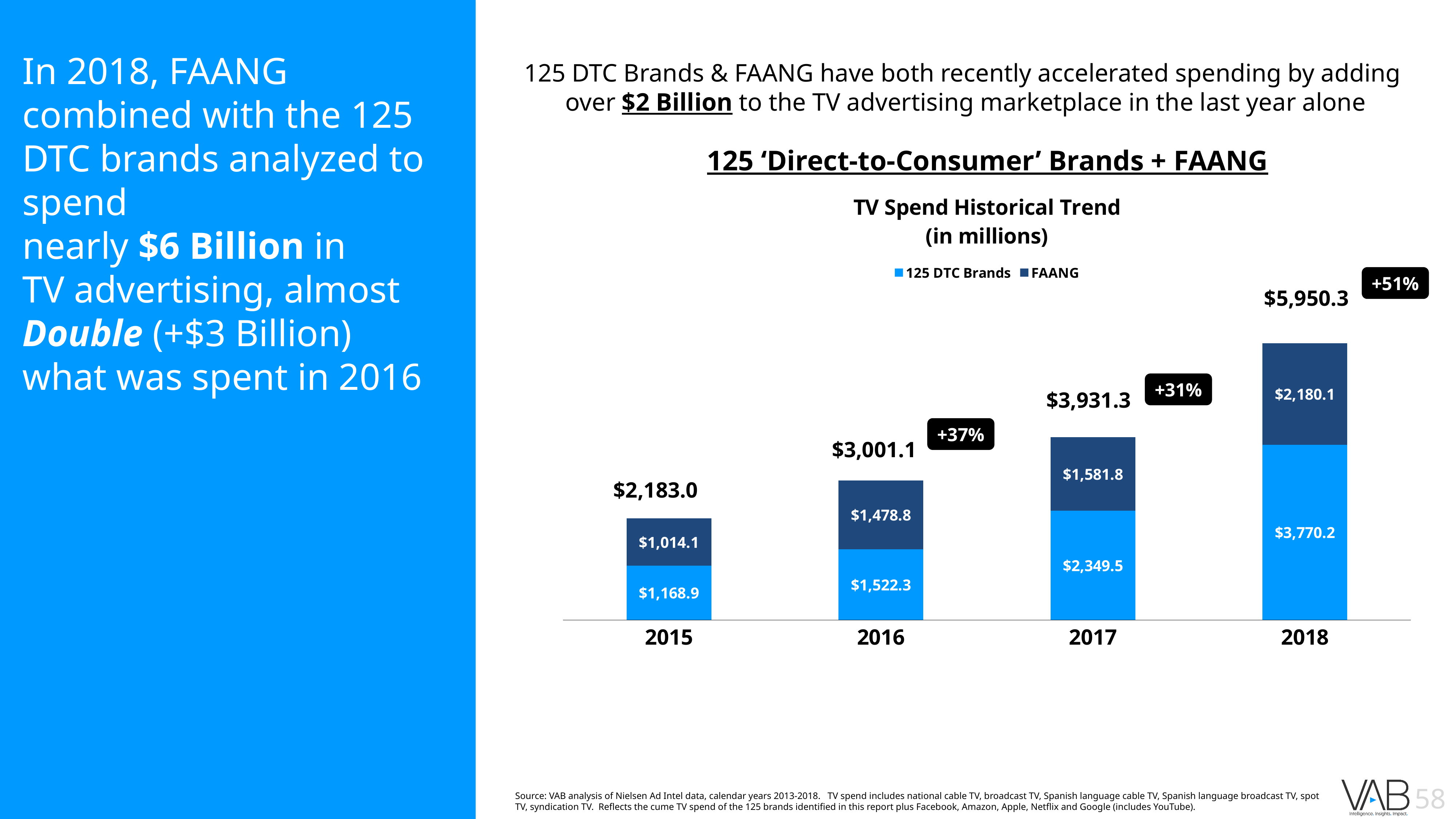
What percentage growth label is shown for 2018? +51% What is the total TV spend shown for 2017? $3,931.3 What was the TV spend for the 125 DTC Brands in 2018? $3,770.2 Which year has the highest total TV spend? 2018 What kind of chart is used to show the TV Spend Historical Trend? Stacked bar chart In 2015, which series spent more on TV: the 125 DTC Brands or FAANG? 125 DTC Brands How many series does the chart legend list? 2 Which year has the lowest total TV spend? 2015 What was the FAANG TV spend in 2016? $1,478.8 What is the difference between the total TV spend in 2018 and in 2016? $2,949.2 How many years are shown on the x axis of the chart? 4 How much greater is the FAANG TV spend in 2018 than in 2017? $598.3